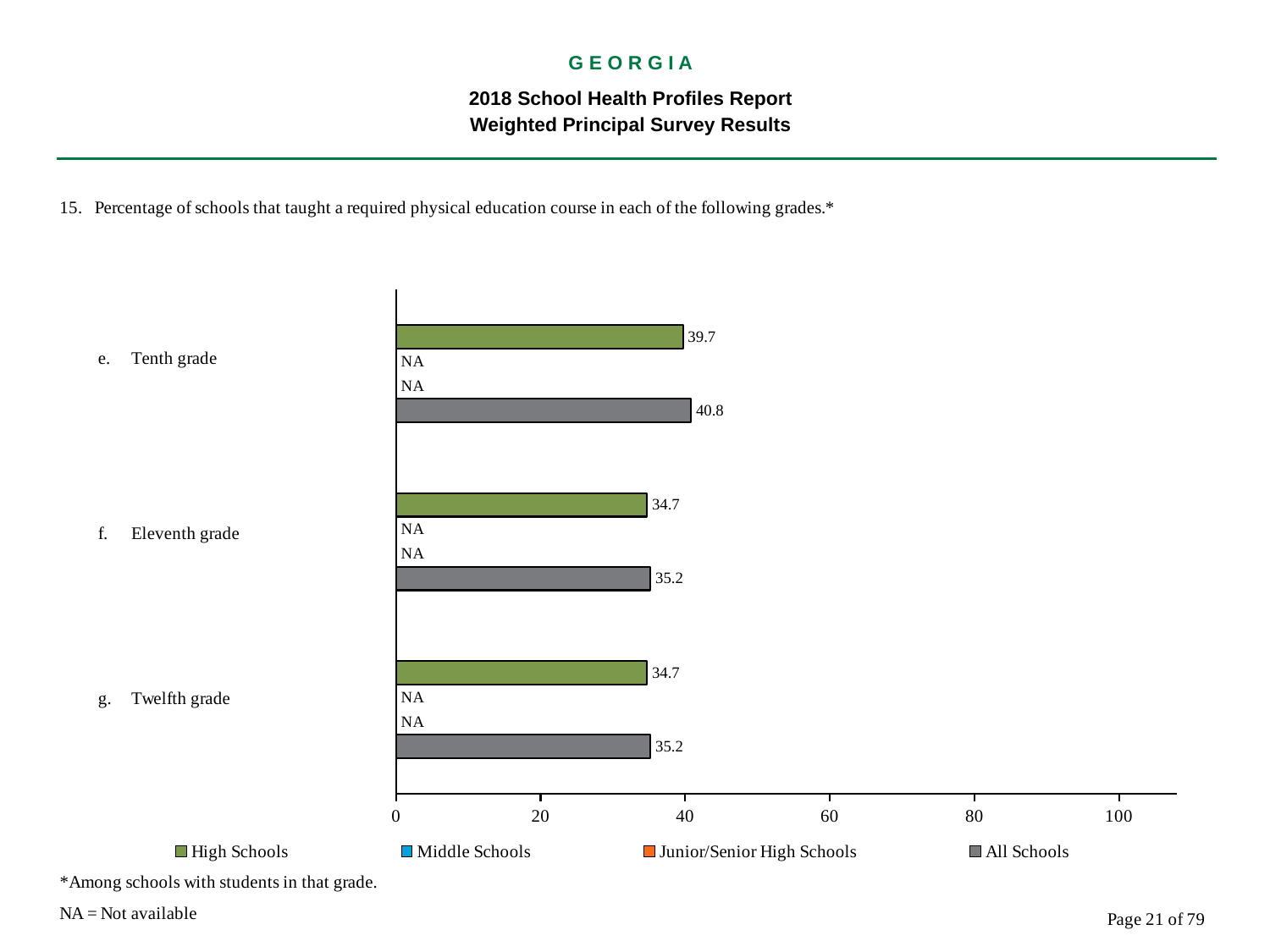
What kind of chart is shown on the slide? bar chart Is the All Schools value for Tenth grade greater or less than 40? greater What is the difference between the All Schools value and the High Schools value for Tenth grade? 1.1 What value is shown for Middle Schools for Twelfth grade? NA Which is larger for Eleventh grade: the High Schools value or the All Schools value? All Schools What is the value for All Schools for Tenth grade? 40.8 How many grade categories are shown on the chart? 3 How many series does the legend list? 4 Which grade has the highest value for All Schools? Tenth grade What is the value for All Schools for Eleventh grade? 35.2 What is the value for High Schools for Tenth grade? 39.7 What is the value for High Schools for Twelfth grade? 34.7